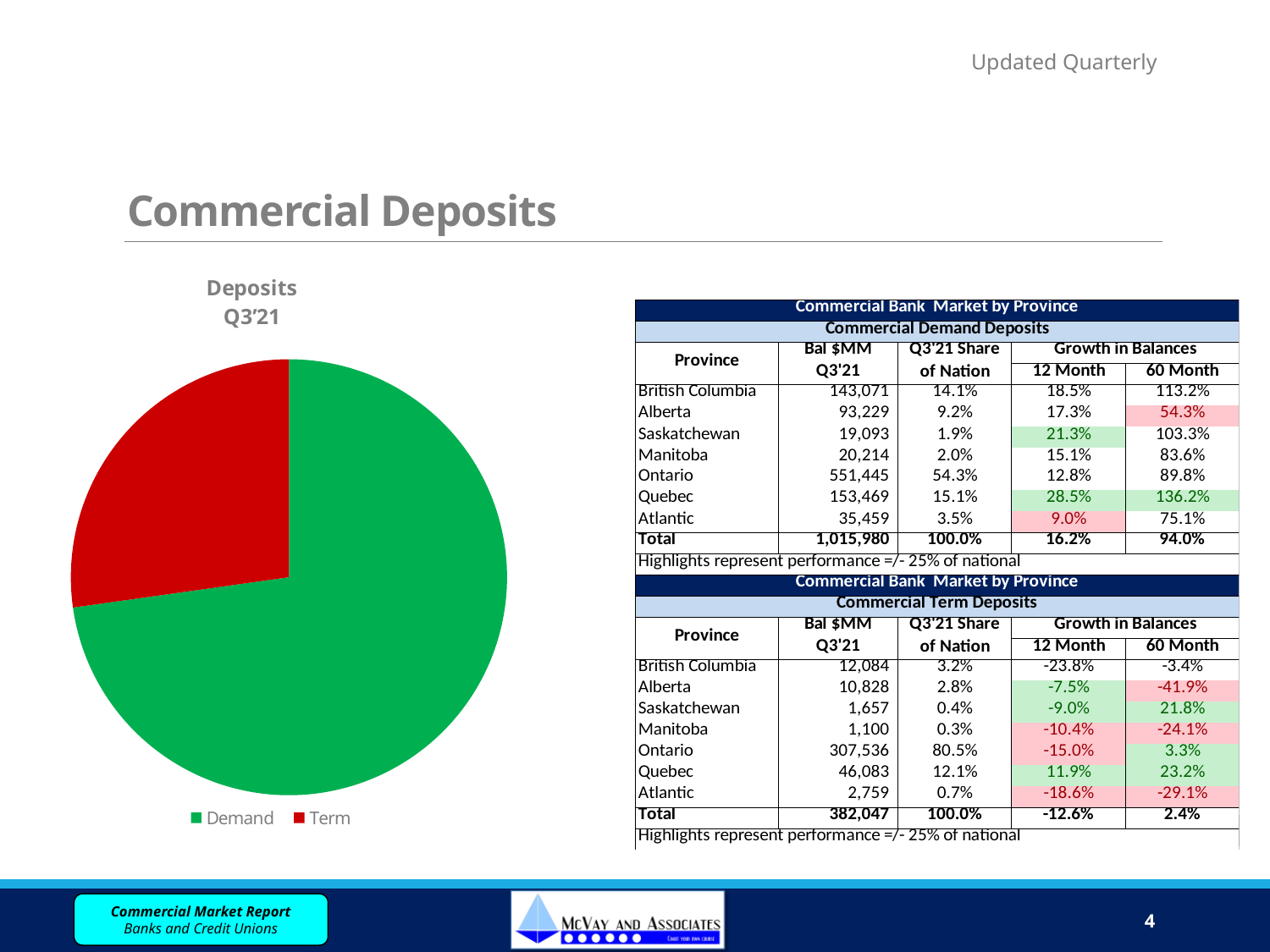
What colour is the Term slice in the pie chart? red What is the title of the pie chart? Deposits Q3'21 In the pie chart, which is larger, Demand or Term? Demand How many entries does the pie chart's legend list? 2 What kind of chart is shown on the slide? pie chart Which slice of the pie chart is the largest? Demand Which slice of the pie chart is the smallest? Term Does the Demand slice take up more or less than half of the pie chart? more How many slices does the pie chart have? 2